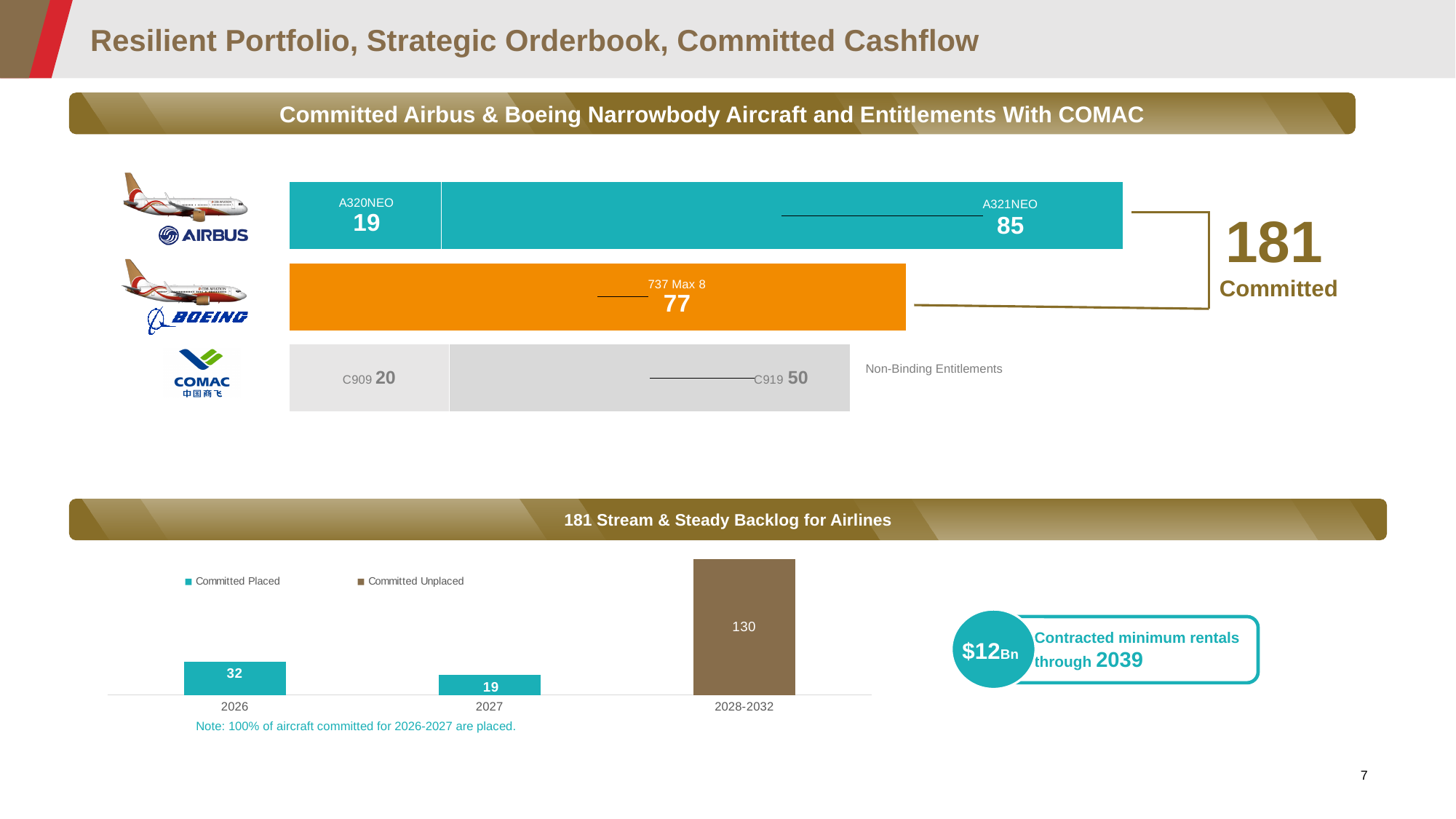
In the bottom chart '181 Stream & Steady Backlog for Airlines', what is the value for 2026? 32 What kind of chart is the bottom chart '181 Stream & Steady Backlog for Airlines'? bar chart In the bottom chart '181 Stream & Steady Backlog for Airlines', what is the value for 2028-2032? 130 In the bottom chart '181 Stream & Steady Backlog for Airlines', what is the value for 2027? 19 In the bottom chart '181 Stream & Steady Backlog for Airlines', how many series does the legend list? 2 In the top chart 'Committed Airbus & Boeing Narrowbody Aircraft and Entitlements With COMAC', what is the total of the Airbus bar (A320NEO plus A321NEO)? 104 In the bottom chart '181 Stream & Steady Backlog for Airlines', which period has the highest value? 2028-2032 In the bottom chart '181 Stream & Steady Backlog for Airlines', how many periods are shown on the x axis? 3 In the bottom chart '181 Stream & Steady Backlog for Airlines', which period has the lowest value? 2027 In the top chart 'Committed Airbus & Boeing Narrowbody Aircraft and Entitlements With COMAC', what is the value for A321NEO? 85 In the bottom chart '181 Stream & Steady Backlog for Airlines', what is the difference between the values for 2026 and 2027? 13 In the top chart 'Committed Airbus & Boeing Narrowbody Aircraft and Entitlements With COMAC', which is larger, the value for 737 Max 8 or the value for C919? 737 Max 8